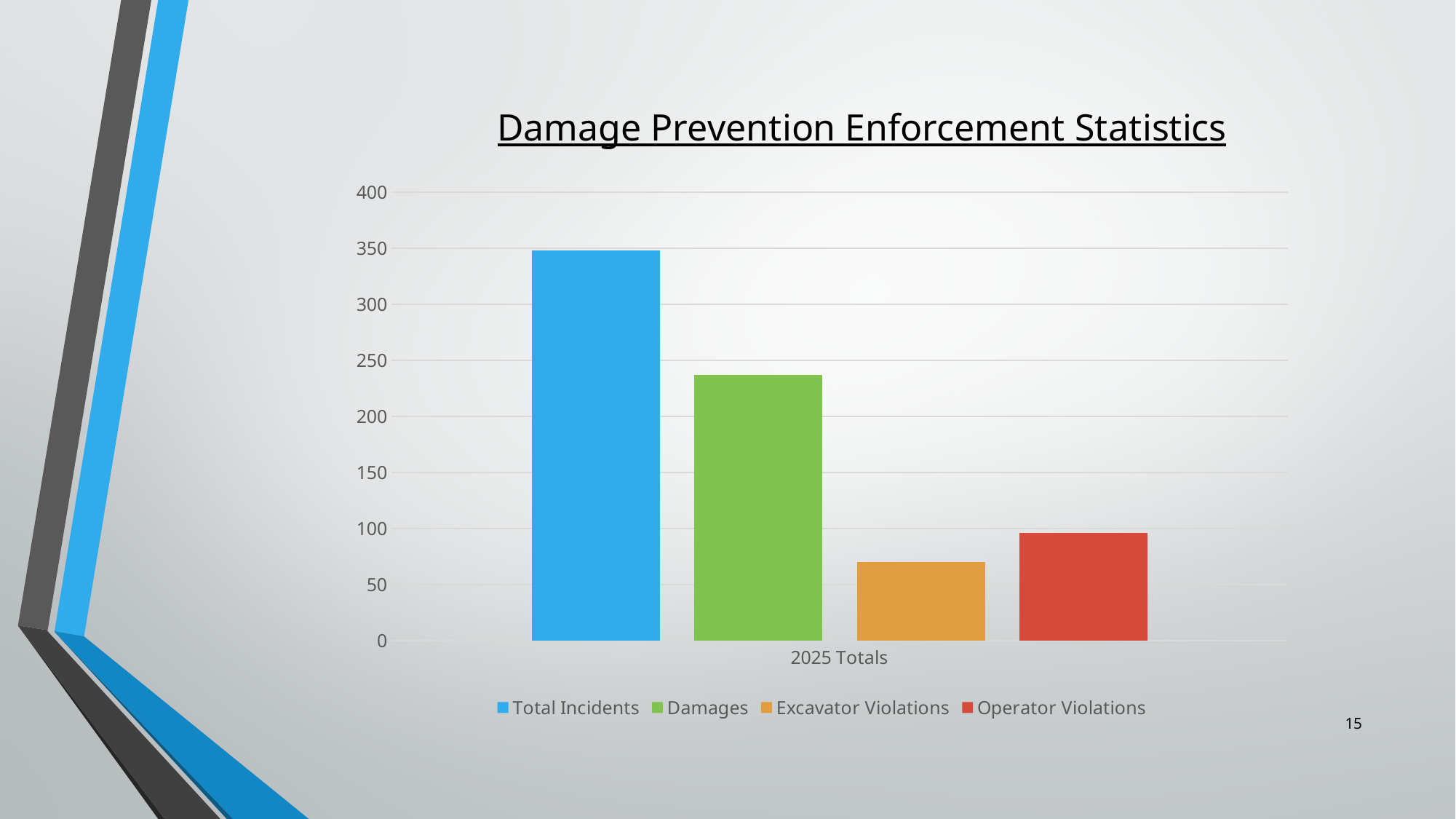
Which is larger, Damages or Operator Violations? Damages What is the category label shown on the x axis? 2025 Totals Is the value for Operator Violations greater or less than 150? less Is the value for Excavator Violations greater or less than 50? greater How many bars are plotted in the chart? 4 Which series has the highest value? Total Incidents Which series has the lowest value? Excavator Violations How many series does the legend list? 4 Is the value for Total Incidents greater or less than 300? greater What kind of chart is shown on the slide? bar chart What is the title of the chart? Damage Prevention Enforcement Statistics